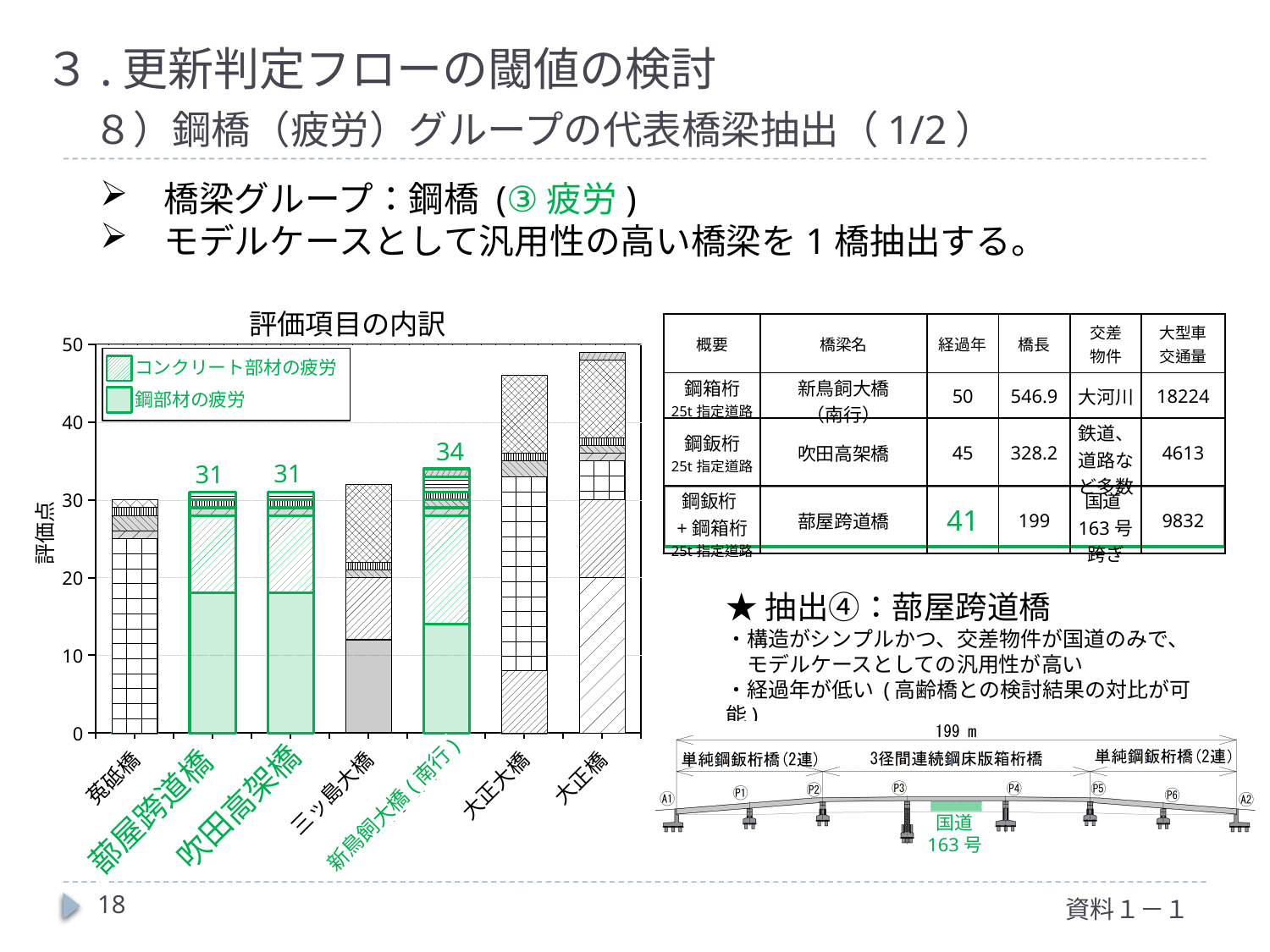
Which bridge has the highest total bar in the 評価項目の内訳 chart? 大正橋 What is the labelled total value for 蔀屋跨道橋 in the 評価項目の内訳 chart? 31 What is the labelled total value for 吹田高架橋 in the 評価項目の内訳 chart? 31 How many series does the legend of the 評価項目の内訳 chart list? 2 How many bridges (categories) are plotted on the x axis of the 評価項目の内訳 chart? 7 What is the difference between the labelled values for 新鳥飼大橋(南行) and 吹田高架橋 in the 評価項目の内訳 chart? 3 In the 評価項目の内訳 chart, which bar is taller: 大正橋 or 蔀屋跨道橋? 大正橋 Is the total value for 大正大橋 in the 評価項目の内訳 chart greater or less than 40? greater What kind of chart is shown under the title 評価項目の内訳? bar chart What is the labelled total value for 新鳥飼大橋(南行) in the 評価項目の内訳 chart? 34 Is the total value for 三ッ島大橋 in the 評価項目の内訳 chart greater or less than 40? less What is the label of the y axis in the 評価項目の内訳 chart? 評価点